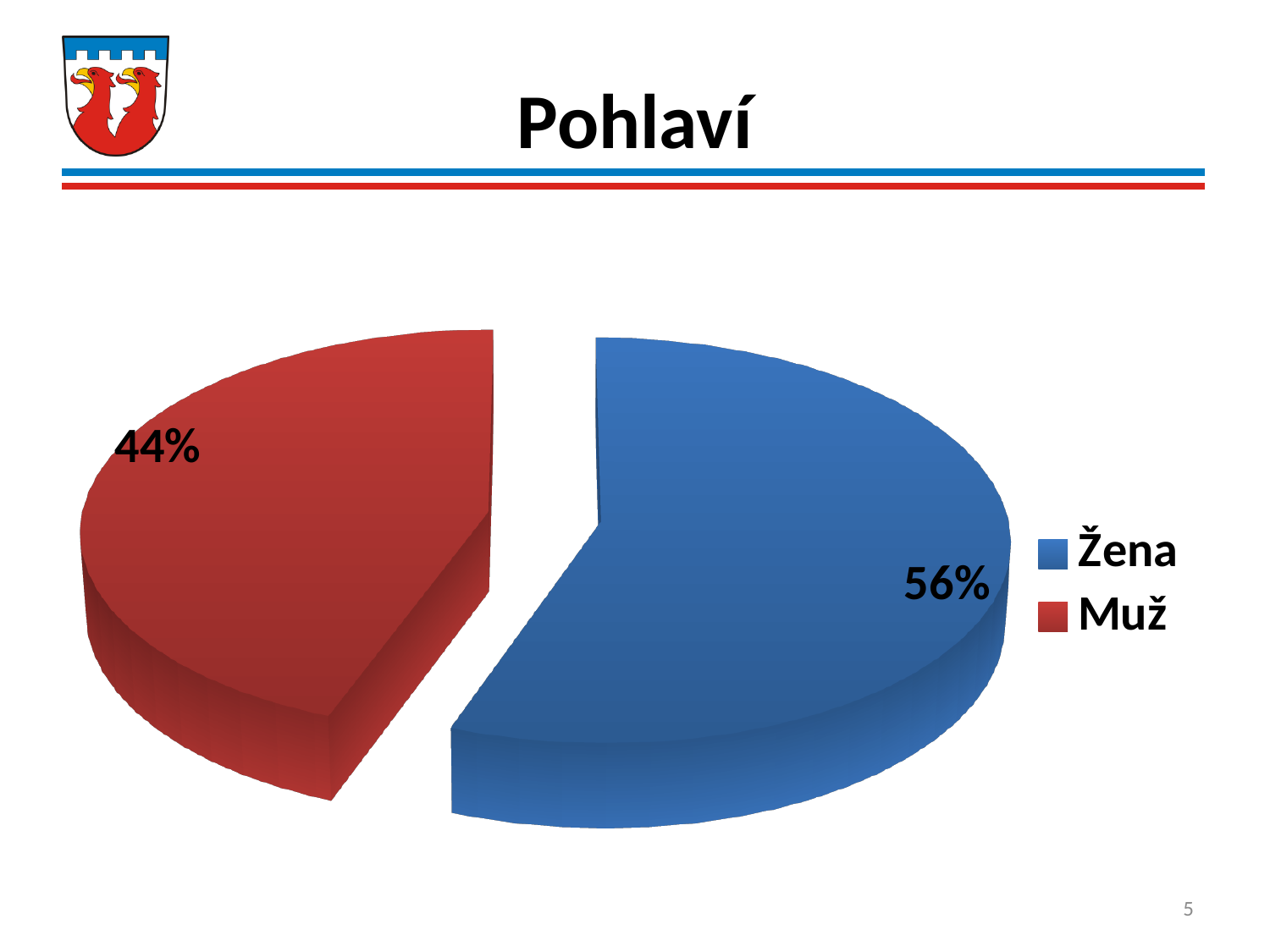
Which category has the smallest slice of the pie? Muž What share of the pie does Muž represent? 44% What colour is the Muž slice? Red What kind of chart is shown on the slide? Pie chart How many categories does the pie chart show? 2 Which category has the largest slice of the pie? Žena What share of the pie does Žena represent? 56% Is the share for Žena greater or less than 50%? greater What is the difference in percentage points between the Žena and Muž slices? 12 percentage points Which slice is larger, Žena or Muž? Žena What is the title of the slide? Pohlaví